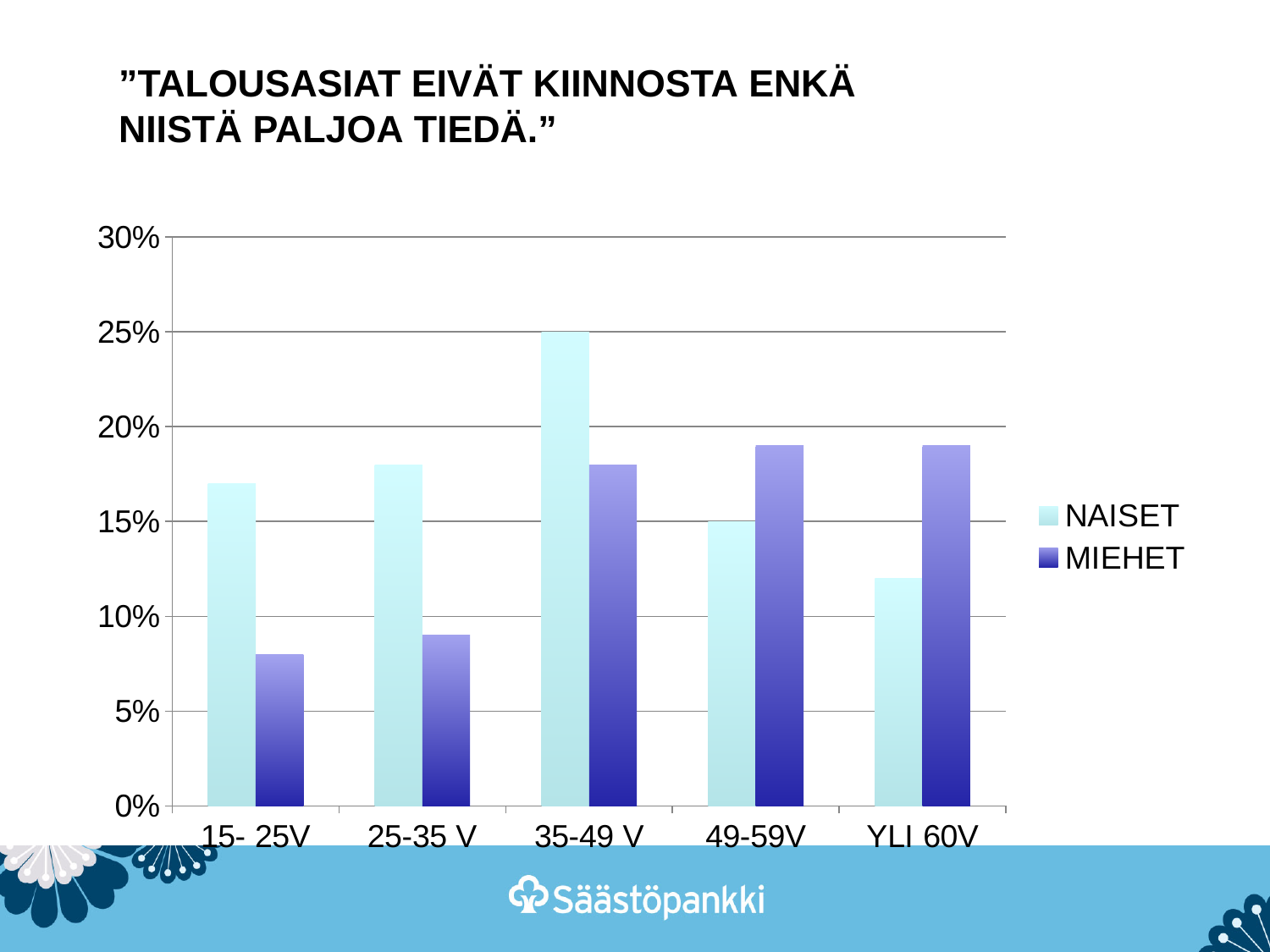
Which age group has the highest NAISET value? 35-49 V What kind of chart is shown on the slide? bar chart Which age group has the lowest NAISET value? YLI 60V What is the NAISET value for the 49-59V age group? 15% Is the MIEHET value for the 15- 25V age group greater or less than 10%? less What is the NAISET value for the 35-49 V age group? 25% Which age group has the lowest MIEHET value? 15- 25V Is the NAISET value for the 25-35 V age group greater or less than 15%? greater How many series does the legend list? 2 How many age categories are shown on the x axis? 5 For the YLI 60V age group, which is larger, the NAISET value or the MIEHET value? MIEHET Which series is shown in light blue in the legend? NAISET